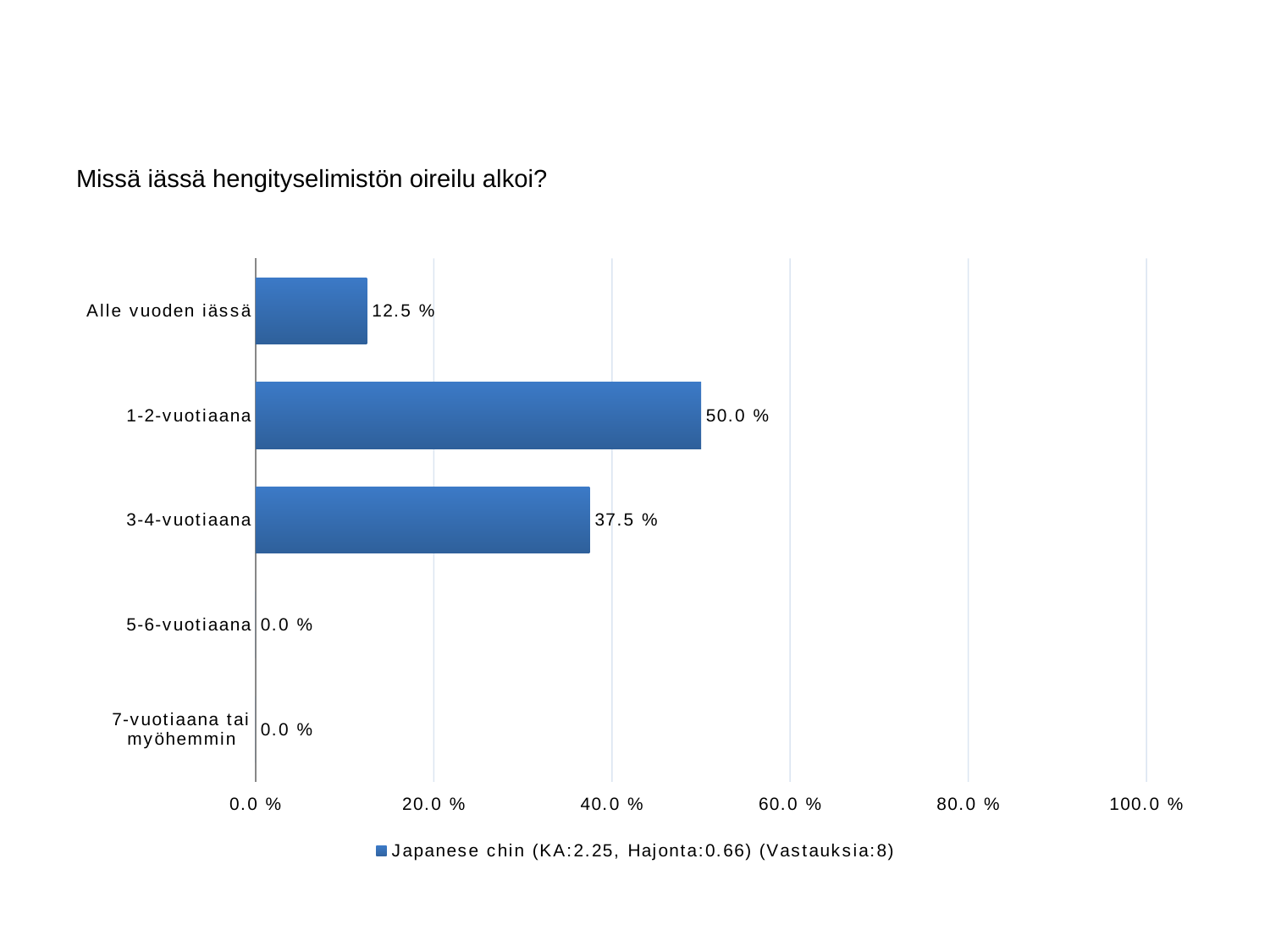
What is the difference between the values for "3-4-vuotiaana" and "Alle vuoden iässä"? 25.0 % What is the value for "Alle vuoden iässä"? 12.5 % What is the value for "1-2-vuotiaana"? 50.0 % What is the value for "5-6-vuotiaana"? 0.0 % Is the value for "1-2-vuotiaana" greater or less than 40.0 %? greater What is the title of the chart? Missä iässä hengityselimistön oireilu alkoi? What is the value for "3-4-vuotiaana"? 37.5 % Which category has the highest value? 1-2-vuotiaana Which is larger, the value for "Alle vuoden iässä" or the value for "3-4-vuotiaana"? 3-4-vuotiaana How many categories are shown on the chart? 5 What kind of chart is shown on the slide? bar chart What is the difference between the values for "1-2-vuotiaana" and "3-4-vuotiaana"? 12.5 %